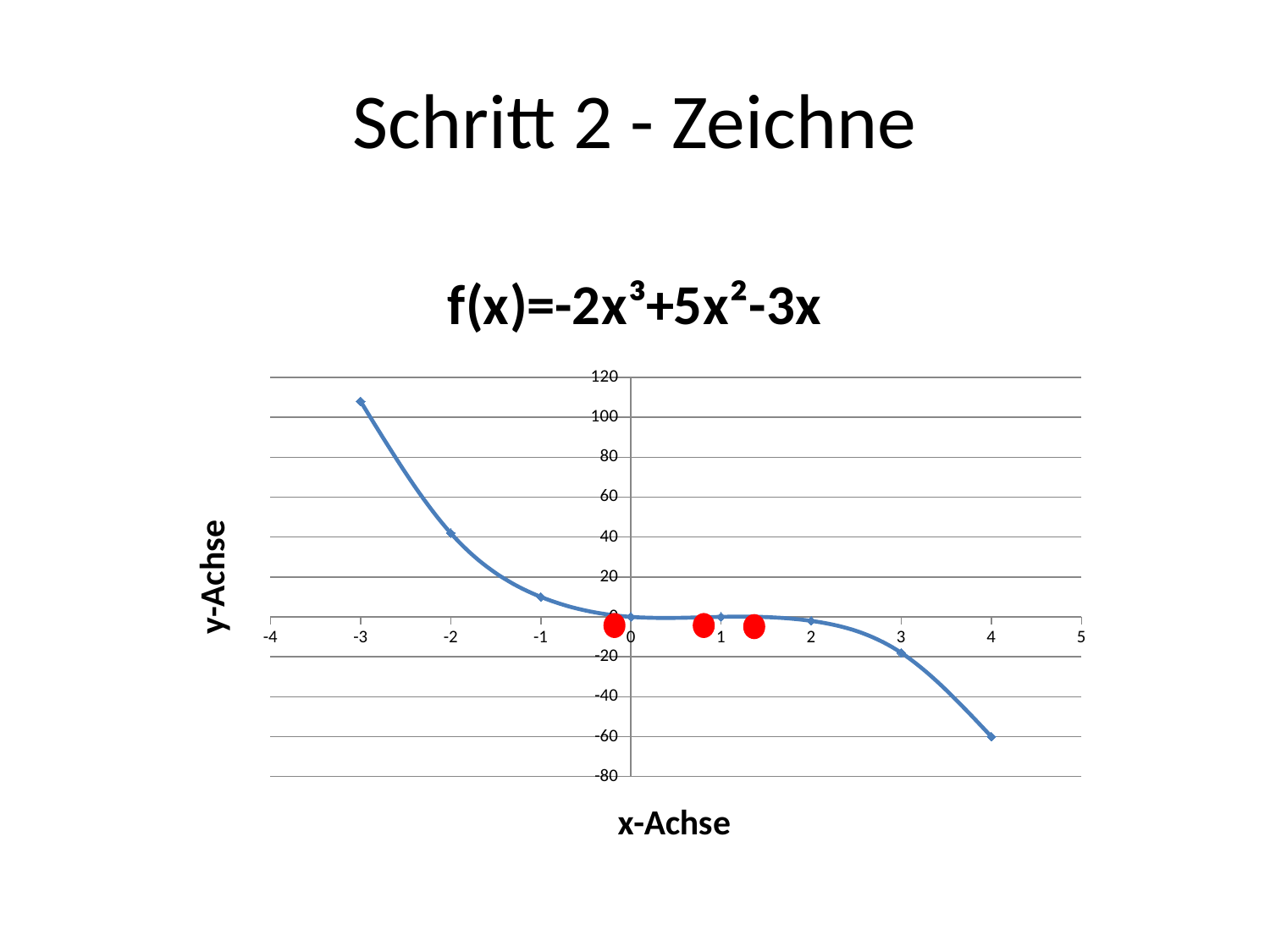
Is the value of the curve at x = -3 greater or less than 100? greater At which x value does the curve reach its highest plotted point? -3 What is the value of the curve at x = 0? 0 What is the label of the horizontal axis? x-Achse Which is larger, the value of the curve at x = -1 or at x = 3? x = -1 What kind of chart is shown on the slide? line chart At which x value does the curve reach its lowest plotted point? 4 Do the plotted values rise or fall as x increases from -3 to 4? fall Is the value of the curve at x = 3 greater or less than 0? less What is the title of the chart? f(x)=-2x³+5x²-3x What is the value of the curve at x = 4? -60